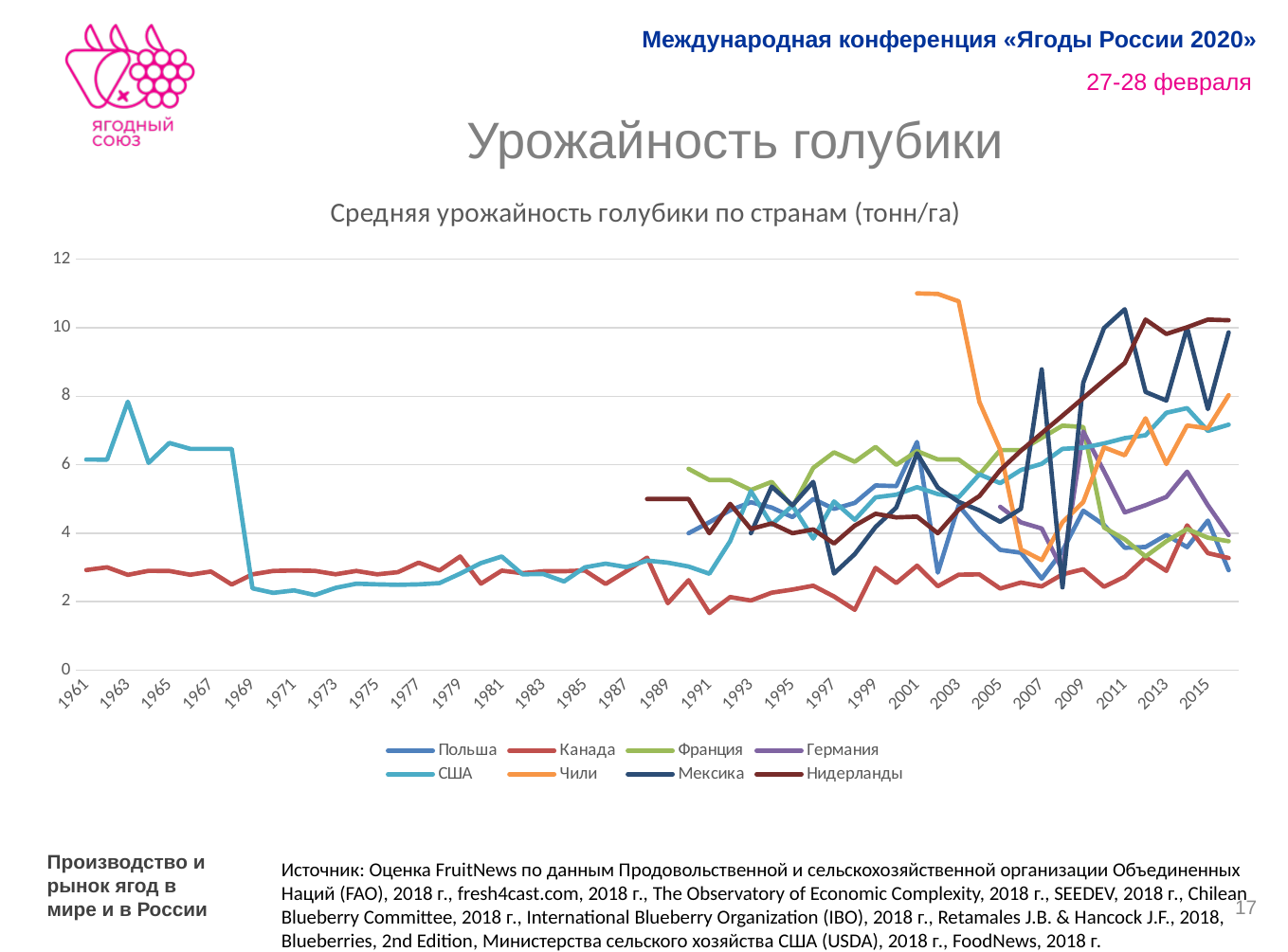
Which colour is used for the Канада series in the chart? red Is the value for Чили in 2001 greater or less than 10? greater Which series reaches the highest value anywhere on the chart? Чили Is the value for Чили in 2007 greater or less than 4? less What is the title of the chart? Средняя урожайность голубики по странам (тонн/га) Is the value for США in 1963 greater or less than 6? greater In 2001, which is larger: the value for Чили or the value for Канада? Чили Does the value for Нидерланды rise or fall from 2003 to 2015? rise How many series does the legend of the chart list? 8 What kind of chart is shown on the slide? line chart